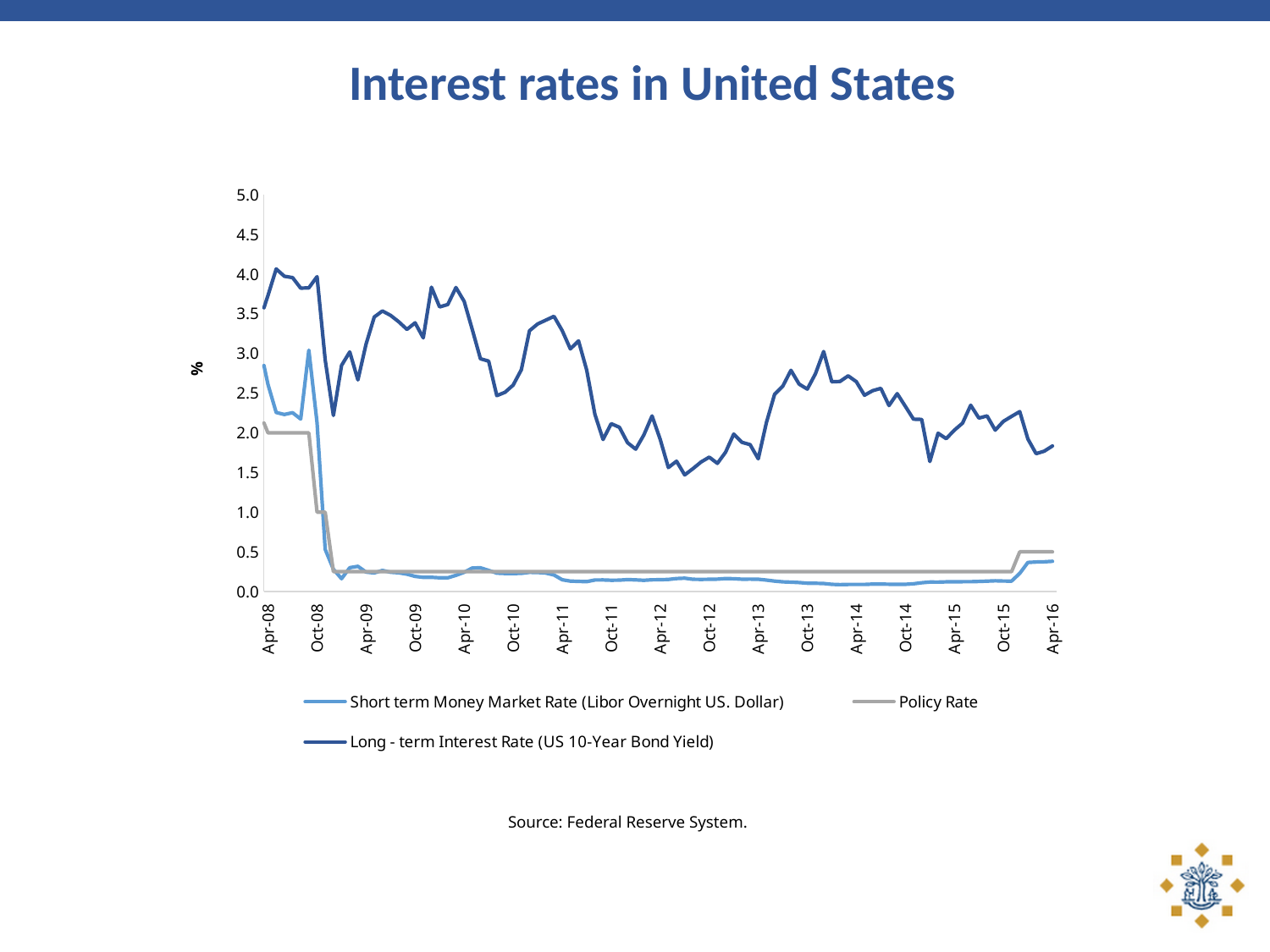
Is the value for the Short term Money Market Rate (Libor Overnight US. Dollar) at Apr-14 greater or less than 0.5? less What is the title of the chart? Interest rates in United States Is the value for the Policy Rate at Apr-08 greater or less than 1.5? greater Is the value for the Long - term Interest Rate (US 10-Year Bond Yield) at Apr-08 greater or less than 3.0? greater What label is shown on the vertical axis? % Which series has the highest value at Apr-08? Long - term Interest Rate (US 10-Year Bond Yield) How many series does the legend list? 3 Does the Policy Rate rise or fall between Apr-08 and Apr-09? fall What kind of chart is shown on the slide? line chart At Apr-16, which is higher: the Long - term Interest Rate (US 10-Year Bond Yield) or the Policy Rate? Long - term Interest Rate (US 10-Year Bond Yield)